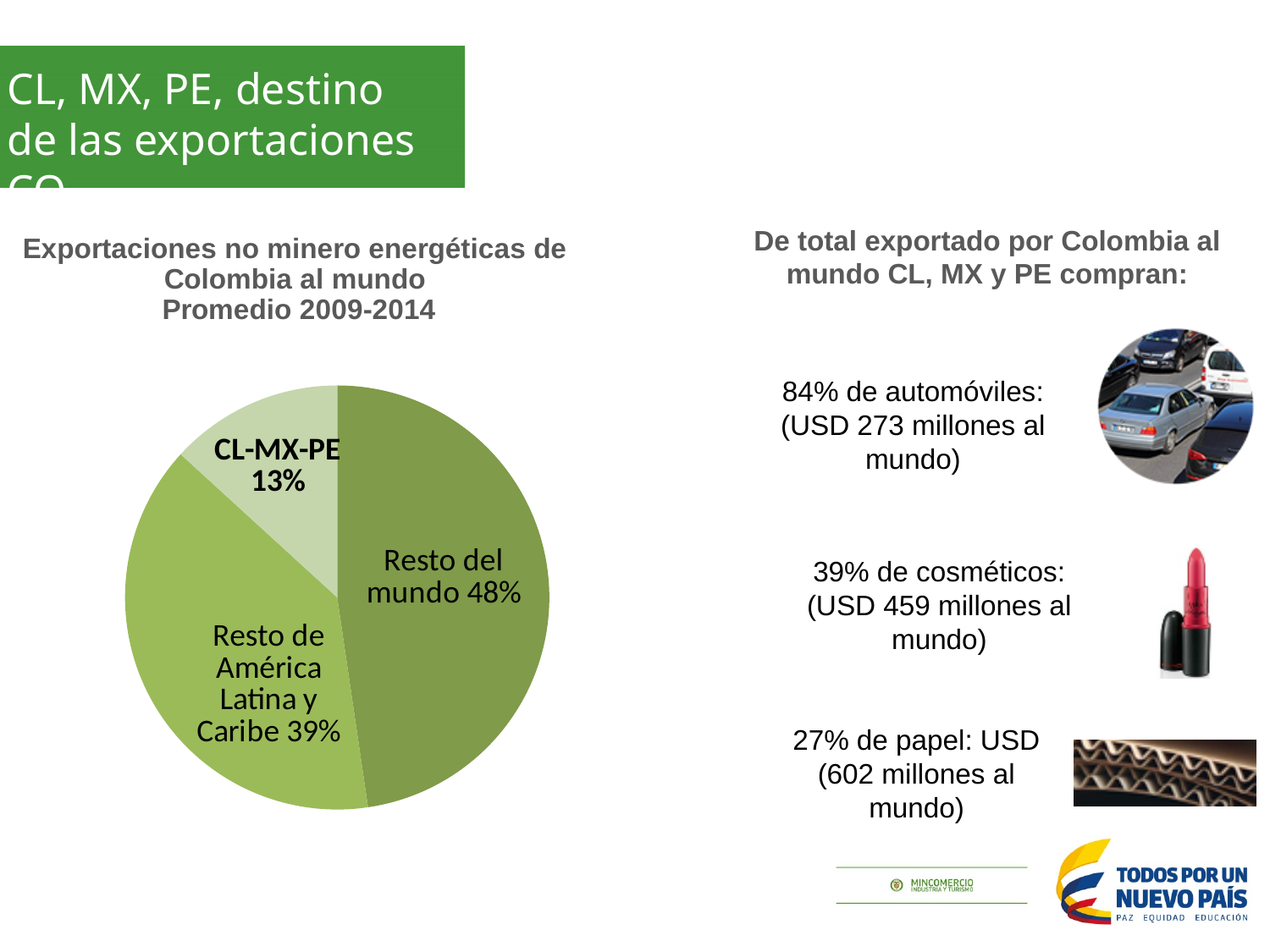
Which is larger, the share for Resto del mundo or the share for Resto de América Latina y Caribe? Resto del mundo Which slice of the pie is the largest? Resto del mundo What share of the pie does Resto del mundo hold? 48% What kind of chart is shown on the slide? pie chart Which slice of the pie is shown in the lightest green colour? CL-MX-PE What is the title of the pie chart? Exportaciones no minero energéticas de Colombia al mundo Promedio 2009-2014 What share of the pie does CL-MX-PE hold? 13% Which slice of the pie is the smallest? CL-MX-PE How many slices does the pie chart have? 3 What is the difference in percentage points between Resto de América Latina y Caribe and CL-MX-PE? 26 What share of the pie does Resto de América Latina y Caribe hold? 39% What is the difference in percentage points between Resto del mundo and CL-MX-PE? 35